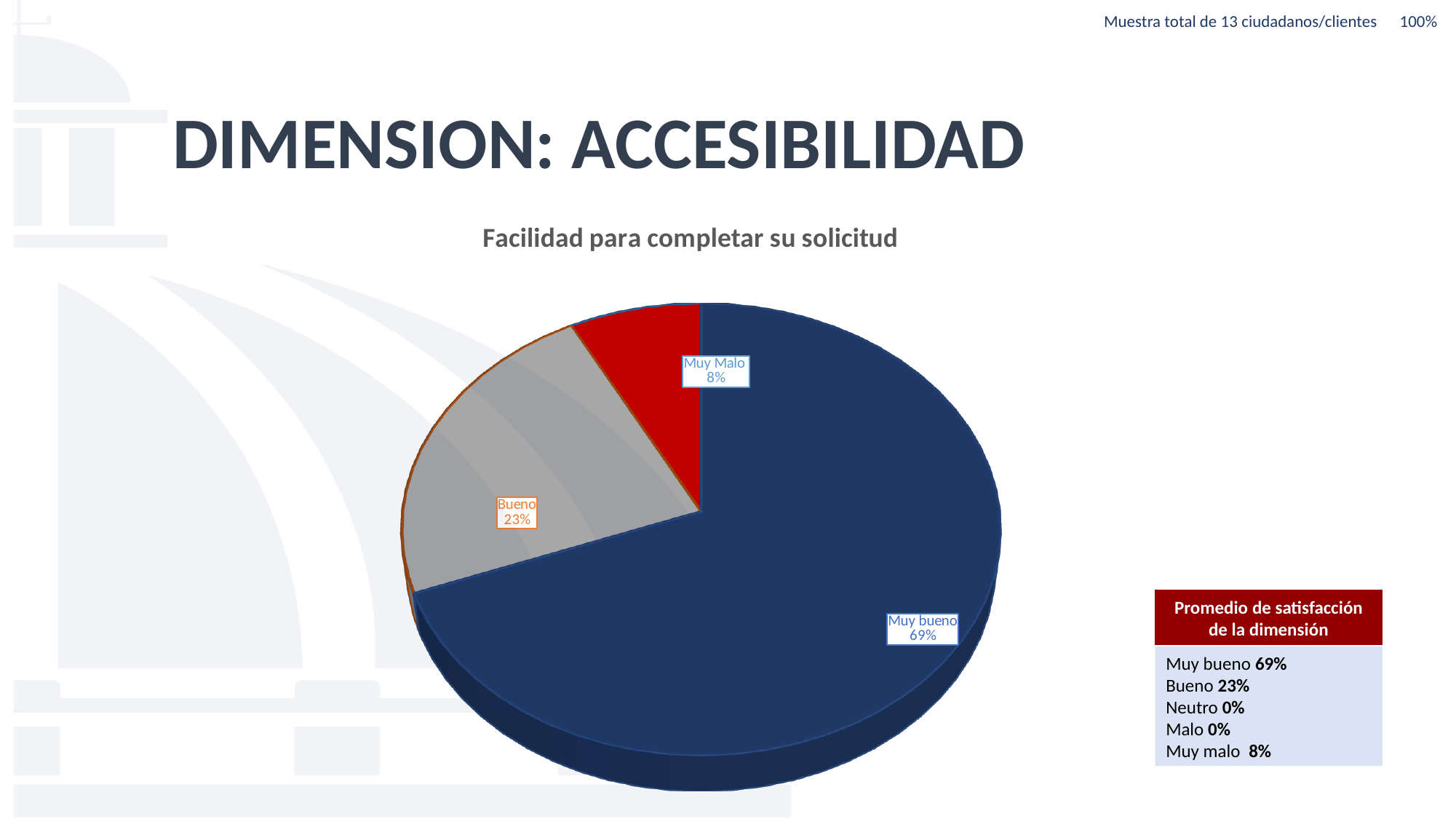
What kind of chart is shown on the slide? pie chart What is the difference in percentage points between Muy bueno and Bueno? 46 What percentage does the Muy Malo slice represent? 8% What is the title of the chart? Facilidad para completar su solicitud How many slices are shown in the pie chart? 3 What percentage does the Muy bueno slice represent? 69% What percentage does the Bueno slice represent? 23% Which is larger, the Bueno slice or the Muy Malo slice? Bueno What colour is the Muy Malo slice? red What is the difference in percentage points between Bueno and Muy Malo? 15 Which category has the smallest slice of the pie? Muy Malo Which category has the largest slice of the pie? Muy bueno